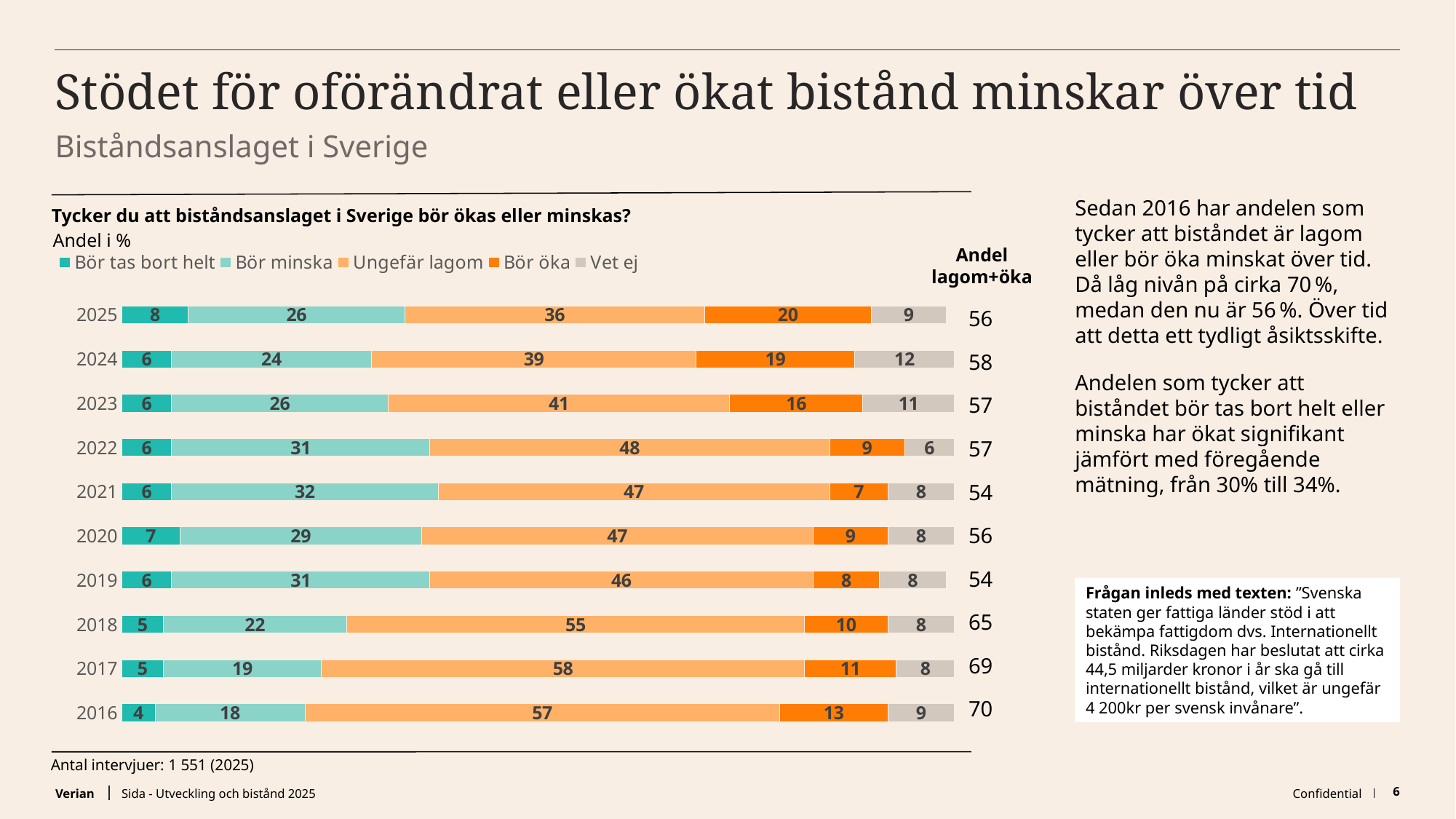
What kind of chart is shown on the slide? Stacked bar chart What is the total of all segments in the 2025 bar? 99 What is the "Andel lagom+öka" value shown for 2024? 58 Does the "Andel lagom+öka" value rise or fall from 2016 to 2025? Fall Which is larger: the "Bör öka" share in 2025 or in 2024? 2025 In which year was the "Ungefär lagom" share highest? 2017 What percentage answered "Bör öka" in 2016? 13 How many years are shown in the chart? 10 What is the difference between the "Bör minska" share in 2025 and in 2016? 8 In which year was the "Bör öka" share lowest? 2021 How many series does the legend list? 5 What percentage answered "Ungefär lagom" in 2025? 36